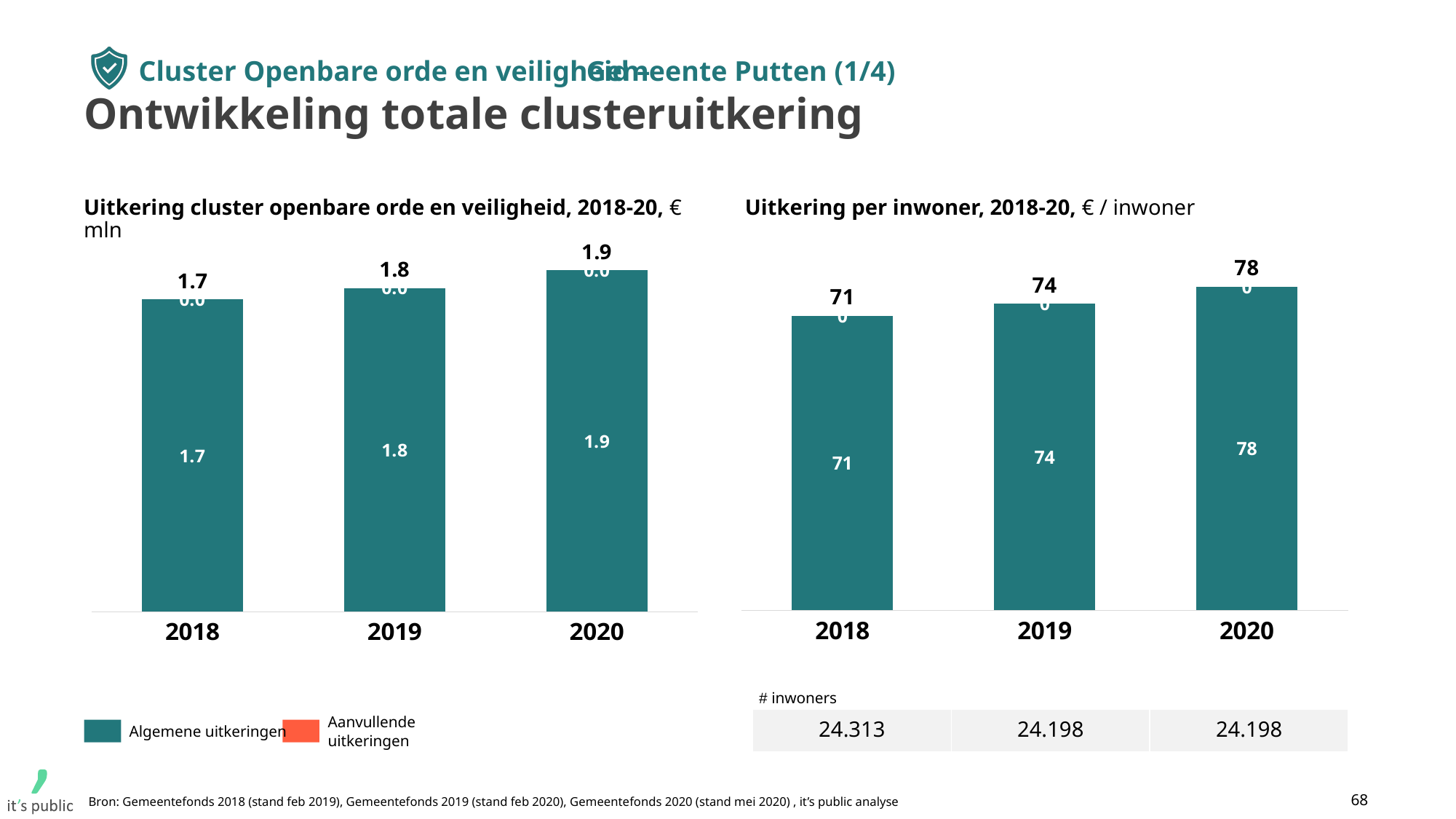
In the chart 'Uitkering per inwoner, 2018-20', do the values rise or fall from 2018 to 2020? rise In the chart 'Uitkering per inwoner, 2018-20', which year has the highest value? 2020 How many years are shown on the x axis of the chart 'Uitkering per inwoner, 2018-20'? 3 In the chart 'Uitkering per inwoner, 2018-20', is the value for 2018 larger or smaller than the value for 2020? smaller How many series does the legend of the chart 'Uitkering cluster openbare orde en veiligheid, 2018-20' list? 2 In the chart 'Uitkering per inwoner, 2018-20', what is the difference between the values for 2020 and 2018? 7 In the chart 'Uitkering cluster openbare orde en veiligheid, 2018-20', what is the total value for 2018? 1.7 In the chart 'Uitkering cluster openbare orde en veiligheid, 2018-20', what is the difference between the totals for 2020 and 2019? 0.1 In the chart 'Uitkering cluster openbare orde en veiligheid, 2018-20', which year has the lowest total? 2018 In the chart 'Uitkering cluster openbare orde en veiligheid, 2018-20', what is the total value for 2020? 1.9 What kind of chart is 'Uitkering per inwoner, 2018-20'? bar chart In the chart 'Uitkering per inwoner, 2018-20', what is the value for 2019? 74